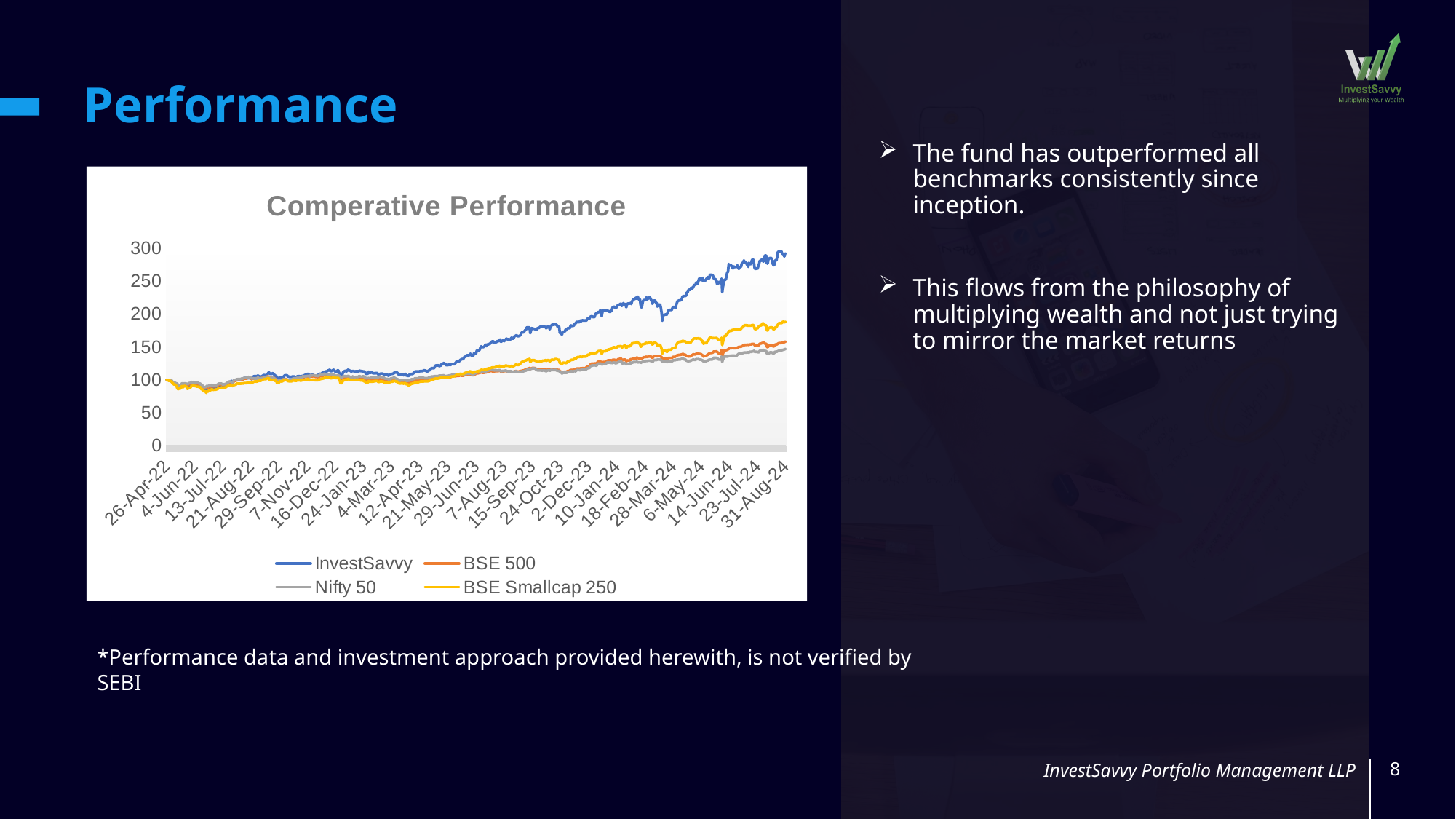
Is the value for InvestSavvy at 31-Aug-24 greater or less than 250? greater What is the title of the chart? Comperative Performance How many series does the chart's legend list? 4 Does the InvestSavvy line generally rise or fall from 26-Apr-22 to 31-Aug-24? Rise Is the value for BSE Smallcap 250 at 31-Aug-24 greater or less than 200? less At 31-Aug-24, which is larger: InvestSavvy or BSE 500? InvestSavvy What is the first date label on the x axis? 26-Apr-22 Is the value for BSE 500 at 31-Aug-24 greater or less than 200? less What kind of chart is shown on the slide? Line chart Which series has the lowest value at the end of the chart (31-Aug-24)? Nifty 50 What is the highest value shown on the y axis? 300 Which series has the highest value at the end of the chart (31-Aug-24)? InvestSavvy